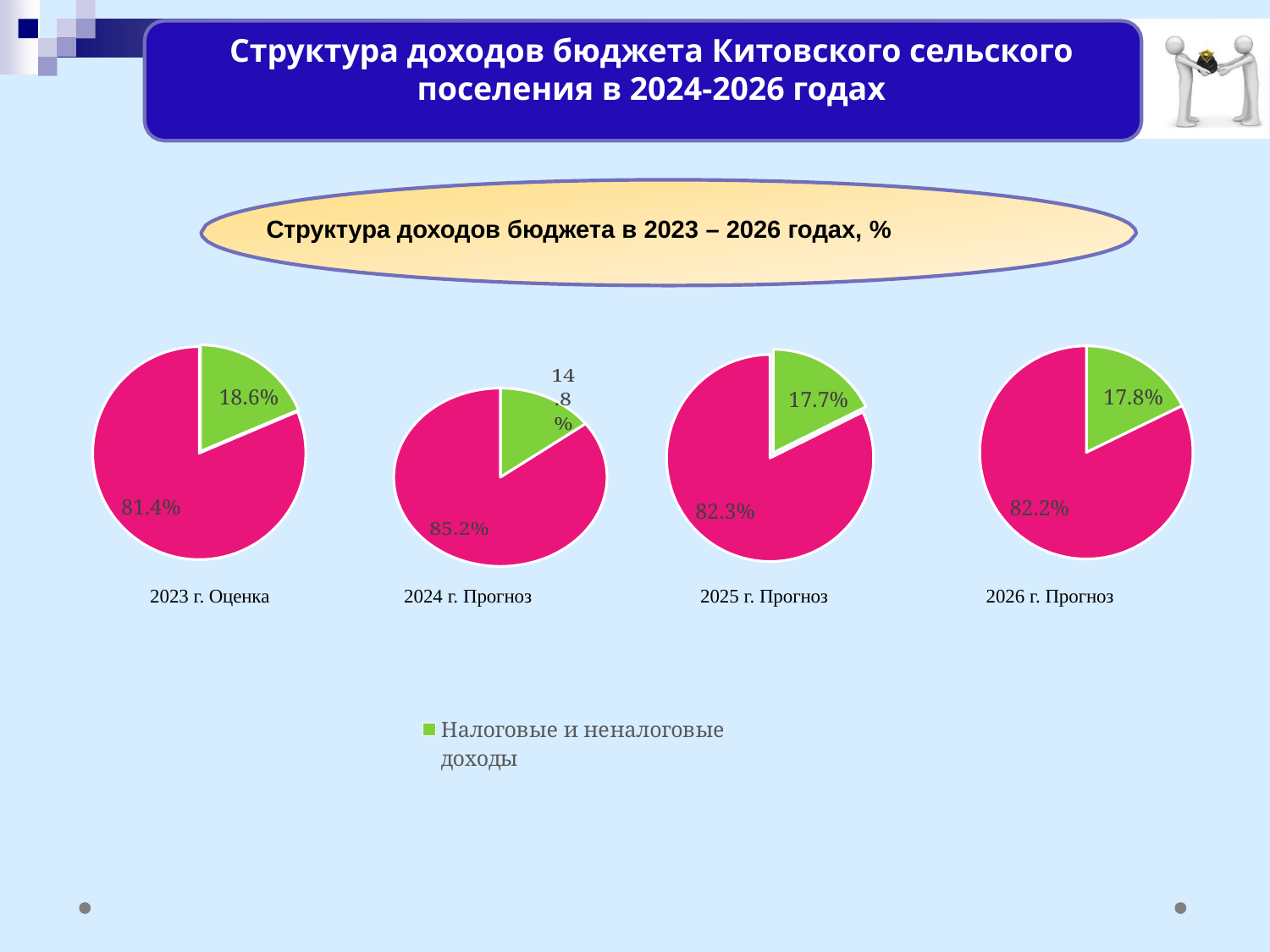
In the pie chart for 2024 г. Прогноз, what share is shown for Налоговые и неналоговые доходы? 14.8% In the pie chart for 2025 г. Прогноз, what share is shown for Налоговые и неналоговые доходы? 17.7% What is the difference between the pink slice shares in the 2024 г. Прогноз and 2023 г. Оценка pie charts? 3.8% In the pie chart for 2024 г. Прогноз, what share is shown for the pink slice? 85.2% Across the four pie charts, which year has the largest share for Налоговые и неналоговые доходы? 2023 г. Оценка Across the four pie charts, which year has the smallest share for Налоговые и неналоговые доходы? 2024 г. Прогноз What type of chart is used to show the budget revenue structure on this slide? Pie chart Which is larger: the green slice in the 2025 г. Прогноз pie chart or the green slice in the 2026 г. Прогноз pie chart? 2026 г. Прогноз In the pie chart for 2023 г. Оценка, what share is labelled for the green slice (Налоговые и неналоговые доходы)? 18.6% How many pie charts are shown on the slide? 4 In the pie chart for 2026 г. Прогноз, what share is shown for the pink slice? 82.2% What series name does the legend list for the green slices? Налоговые и неналоговые доходы